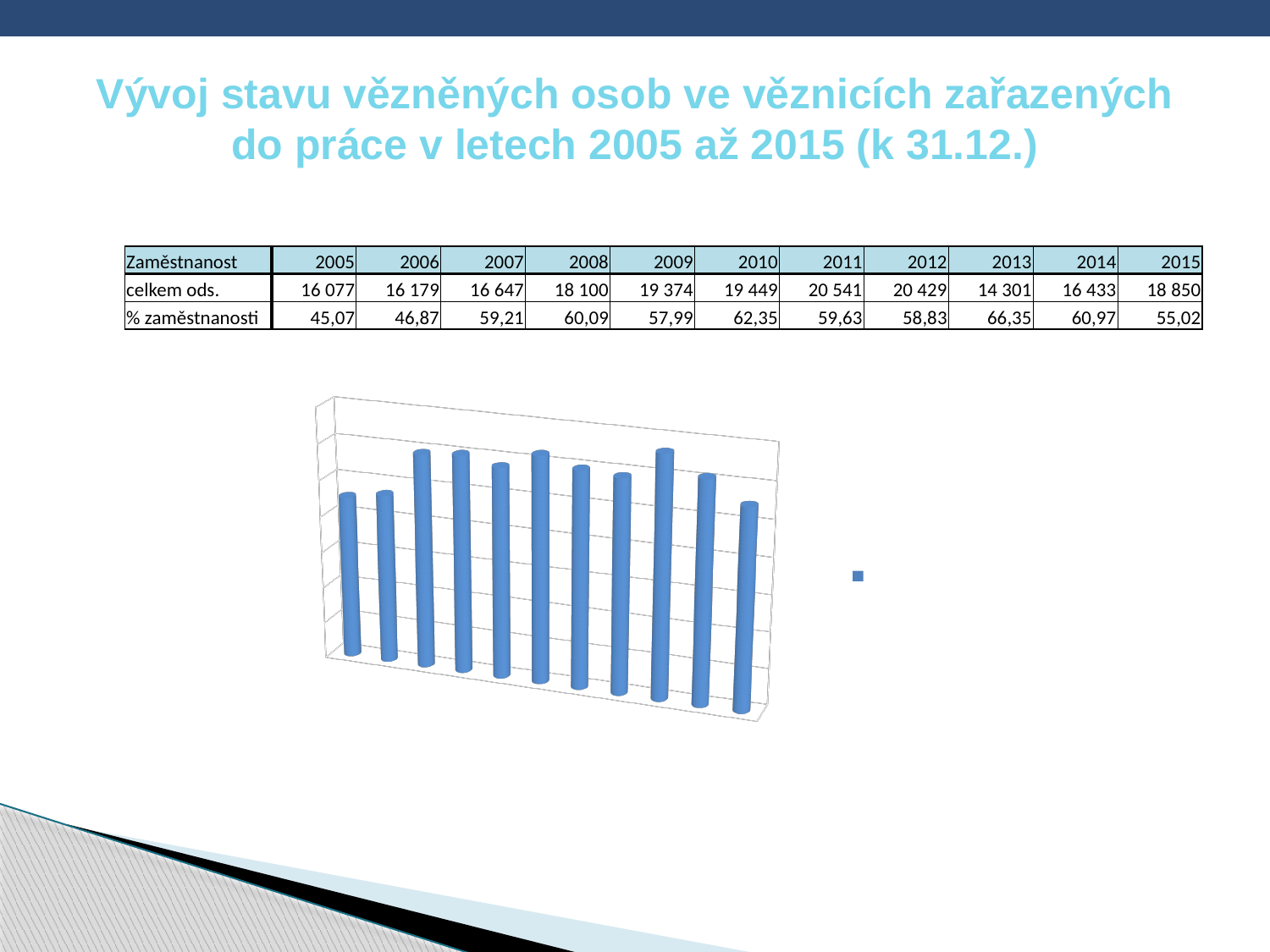
Is the first bar from the left taller or shorter than the third bar from the left? shorter Counting from the left, which bar in the chart is the shortest? the first bar Does the chart display any axis labels or data labels? no What kind of chart is shown on the slide? bar chart What colour are the bars in the chart? blue Do the bars rise or fall from the first bar to the third bar? rise Do the bars rise or fall from the ninth bar to the eleventh bar? fall How many bars does the chart contain? 11 Counting from the left, which bar in the chart is the tallest? the ninth bar Is the ninth bar from the left taller or shorter than the eleventh (last) bar? taller